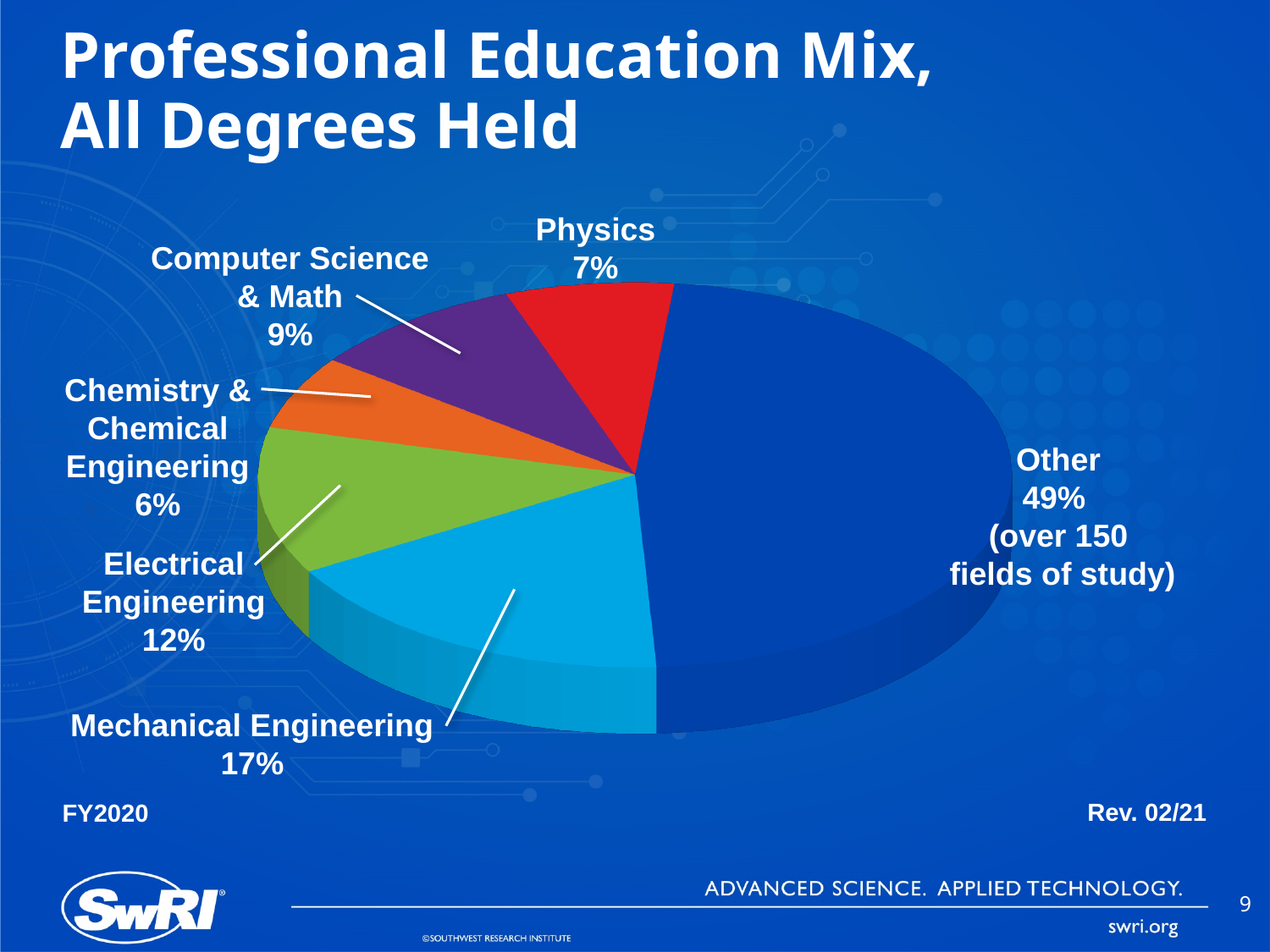
What is the title of the slide containing the chart? Professional Education Mix, All Degrees Held What percentage is shown for Electrical Engineering? 12% What percentage is shown for Computer Science & Math? 9% What percentage is shown for Physics? 7% What kind of chart is shown on the slide? Pie chart Which category has the smallest slice of the pie? Chemistry & Chemical Engineering What share of the pie does Mechanical Engineering hold? 17% Which category has the largest slice of the pie? Other What percentage is shown for Chemistry & Chemical Engineering? 6% How many slices does the pie chart have? 6 What is the difference in percentage points between Mechanical Engineering and Electrical Engineering? 5 Which is larger, the share for Computer Science & Math or the share for Physics? Computer Science & Math